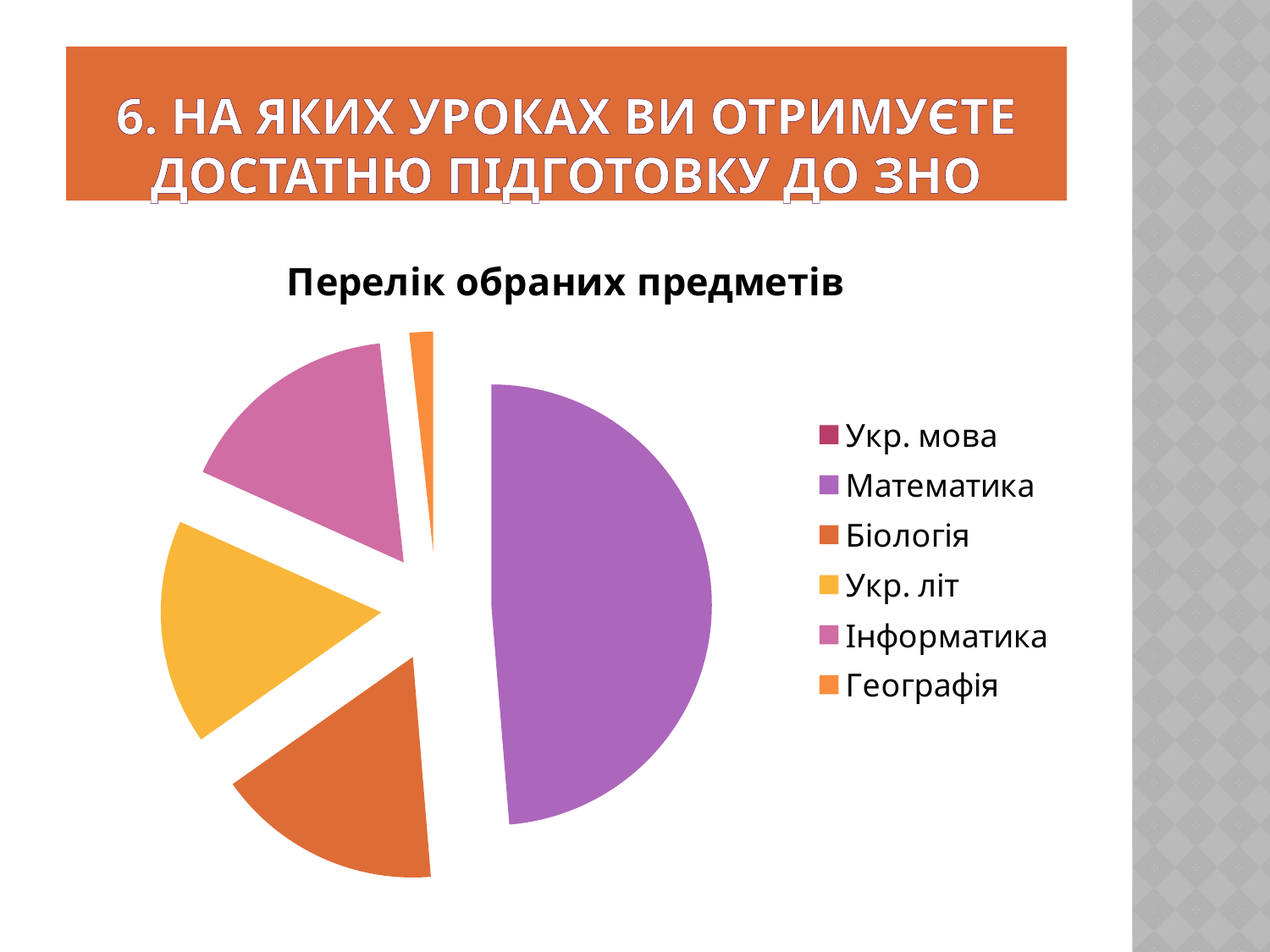
What colour is the slice for Математика? purple Which subject has the largest slice of the pie? Математика What kind of chart is shown on the slide? pie chart What is the title of the chart? Перелік обраних предметів Which slice is larger, Укр. літ or Географія? Укр. літ Which slice is larger, Інформатика or Географія? Інформатика Which slice is larger, Математика or Біологія? Математика How many entries does the chart legend list? 6 Which subject has the smallest visible slice of the pie? Географія